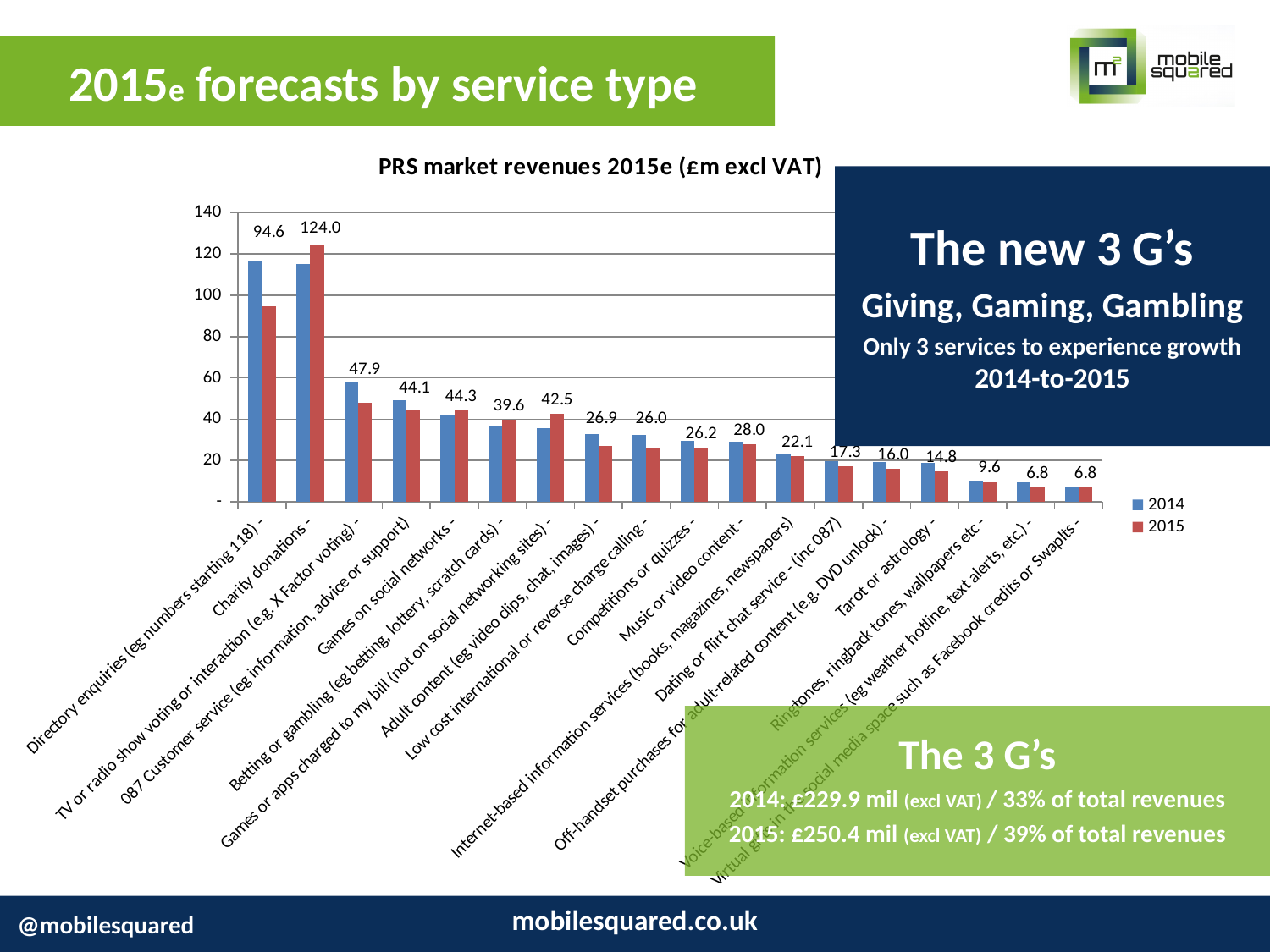
Which category has the highest 2015 value? Charity donations Is the 2014 value for Directory enquiries greater or less than 100? greater For Directory enquiries, which is larger: the 2014 value or the 2015 value? 2014 What is the title of the chart? PRS market revenues 2015e (£m excl VAT) What kind of chart is shown on the slide? bar chart What is the 2015 value for Betting or gambling (eg betting, lottery, scratch cards)? 39.6 What is the 2015 value for Charity donations? 124.0 Which has the larger 2015 value: Betting or gambling, or Games or apps charged to my bill? Games or apps charged to my bill How many series does the legend list? 2 What is the 2015 value for Tarot or astrology? 14.8 What is the difference between the 2015 values for Charity donations and Directory enquiries? 29.4 What is the 2015 value for Directory enquiries (eg numbers starting 118)? 94.6